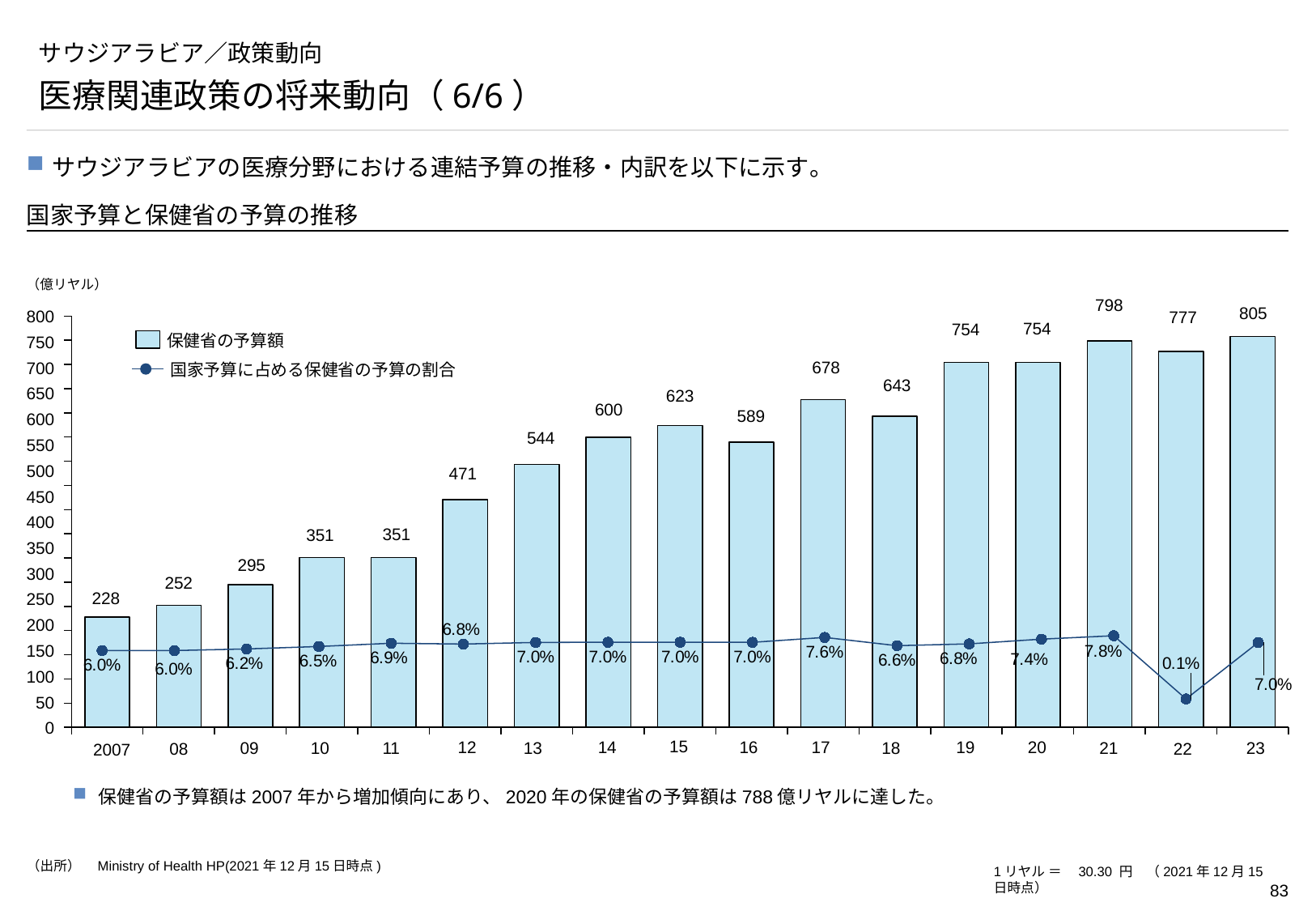
In which year is the 国家予算に占める保健省の予算の割合 lowest? 22 Which year has the larger 保健省の予算額, 16 or 17? 17 What is the 保健省の予算額 (Ministry of Health budget) for 2007? 228 Which year has the highest 保健省の予算額? 23 What is the 保健省の予算額 value shown for 23? 805 What is the difference between the 保健省の予算額 for 23 and for 2007? 577 What kind of chart is used to show the 保健省の予算額? Bar chart (with a line for the share) What is the 国家予算に占める保健省の予算の割合 for 21? 7.8% How many series does the chart legend list? 2 Does the 保健省の予算額 generally rise or fall from 2007 to 23? Rise How many years are shown on the x axis of the chart? 17 Which year has the lowest 保健省の予算額? 2007